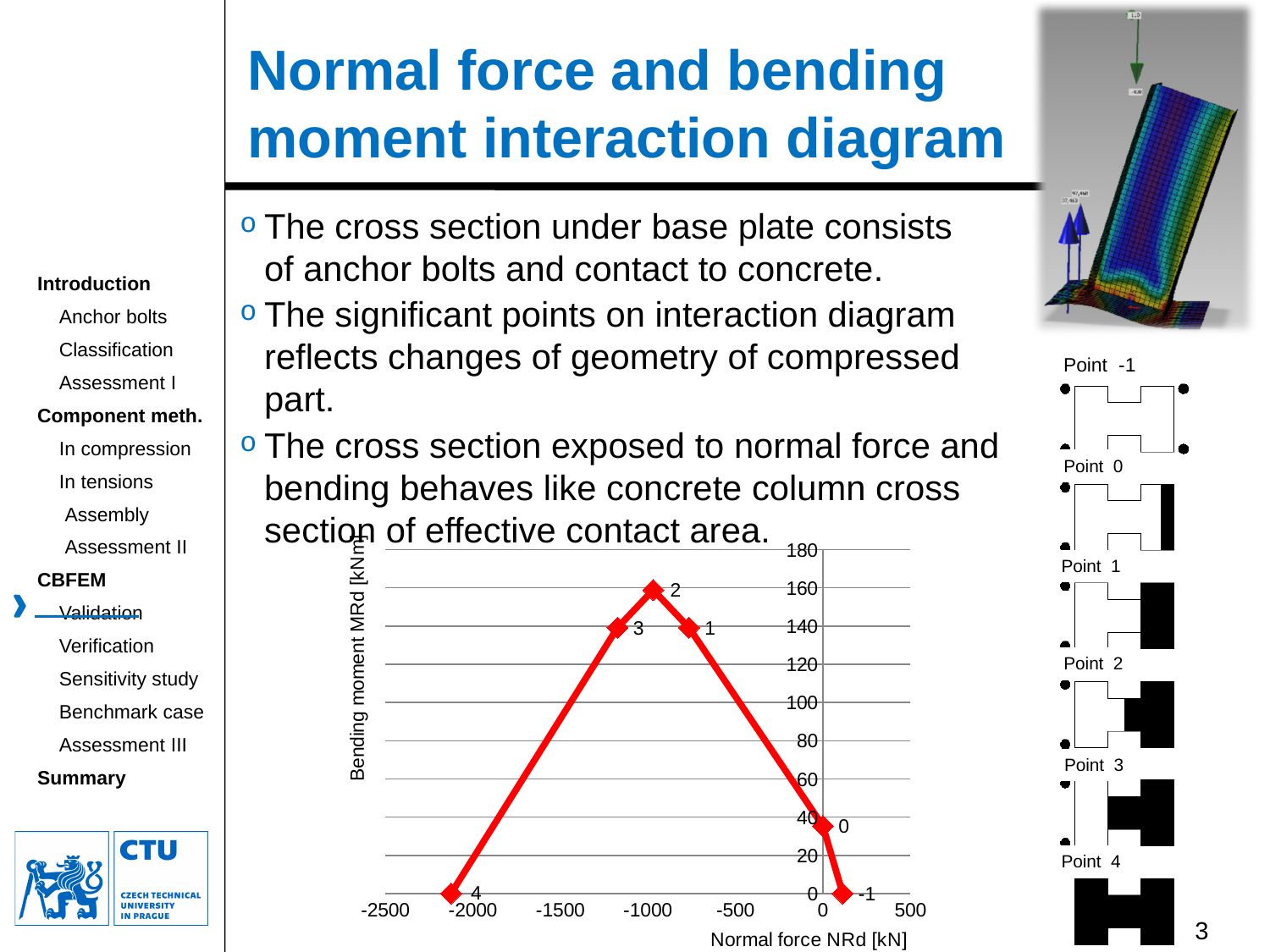
What kind of chart is shown on the slide? line chart What is the title of the y axis of the chart? Bending moment MRd [kNm] How many labelled points are plotted on the interaction diagram? 6 What is the normal force NRd at point 0? 0 What is the title of the x axis of the chart? Normal force NRd [kN] Is the normal force NRd at point 3 greater or less than -1000? less Which point has a larger bending moment MRd, point 0 or point 3? point 3 Is the normal force NRd at point 4 greater or less than -1500? less Which labelled point has the highest bending moment MRd? 2